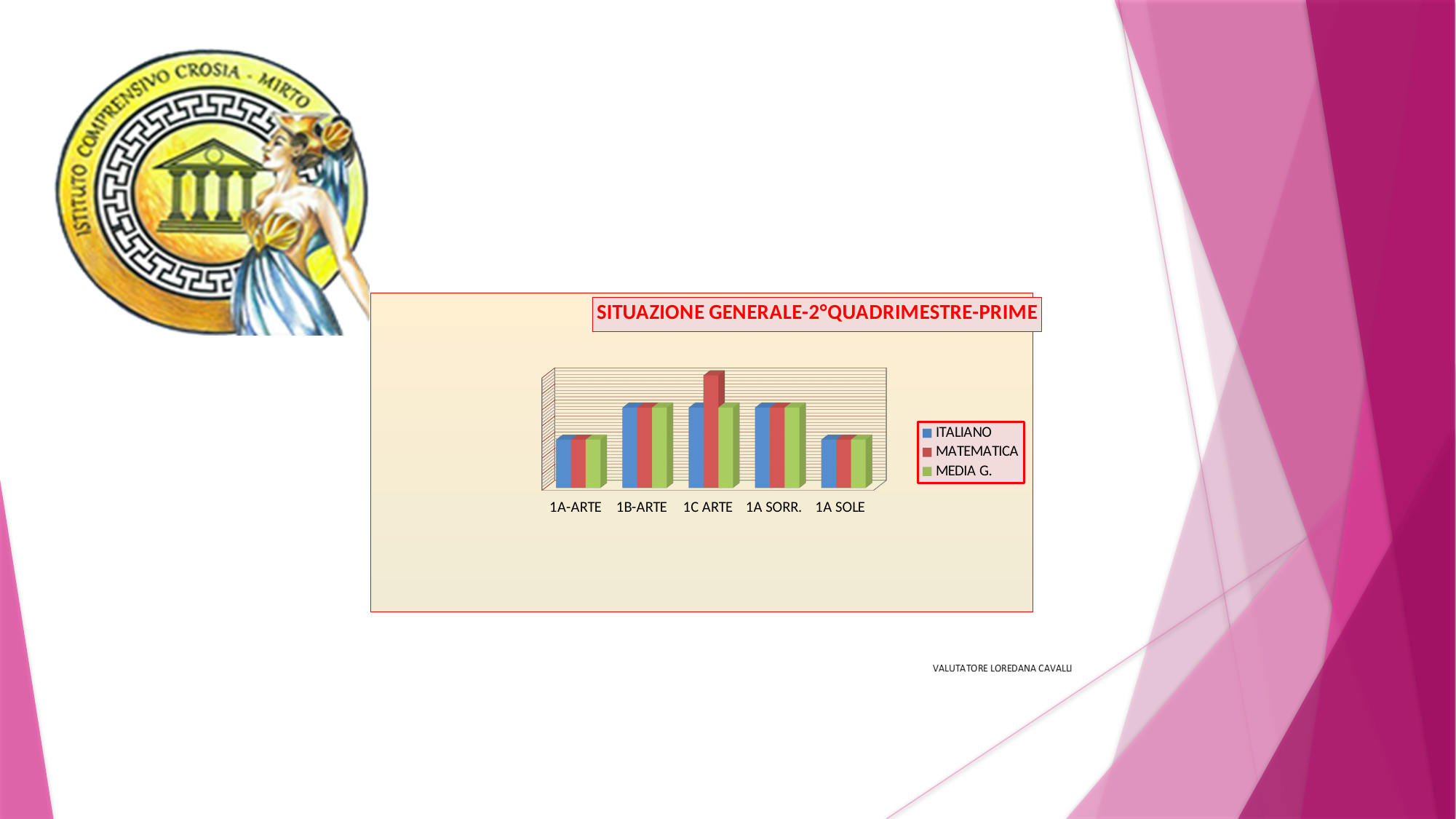
For 1C ARTE, which is larger: the ITALIANO bar or the MATEMATICA bar? MATEMATICA What is the title of the chart? SITUAZIONE GENERALE-2°QUADRIMESTRE-PRIME What kind of chart is shown on the slide? bar chart Which series is shown in red in the chart? MATEMATICA How many categories are shown on the x axis of the chart? 5 Which category has the highest MATEMATICA bar? 1C ARTE How many series does the chart's legend list? 3 Which is larger: the MEDIA G. bar for 1A SORR. or the MEDIA G. bar for 1A SOLE? 1A SORR. Which is larger: the ITALIANO bar for 1B-ARTE or the ITALIANO bar for 1A-ARTE? 1B-ARTE